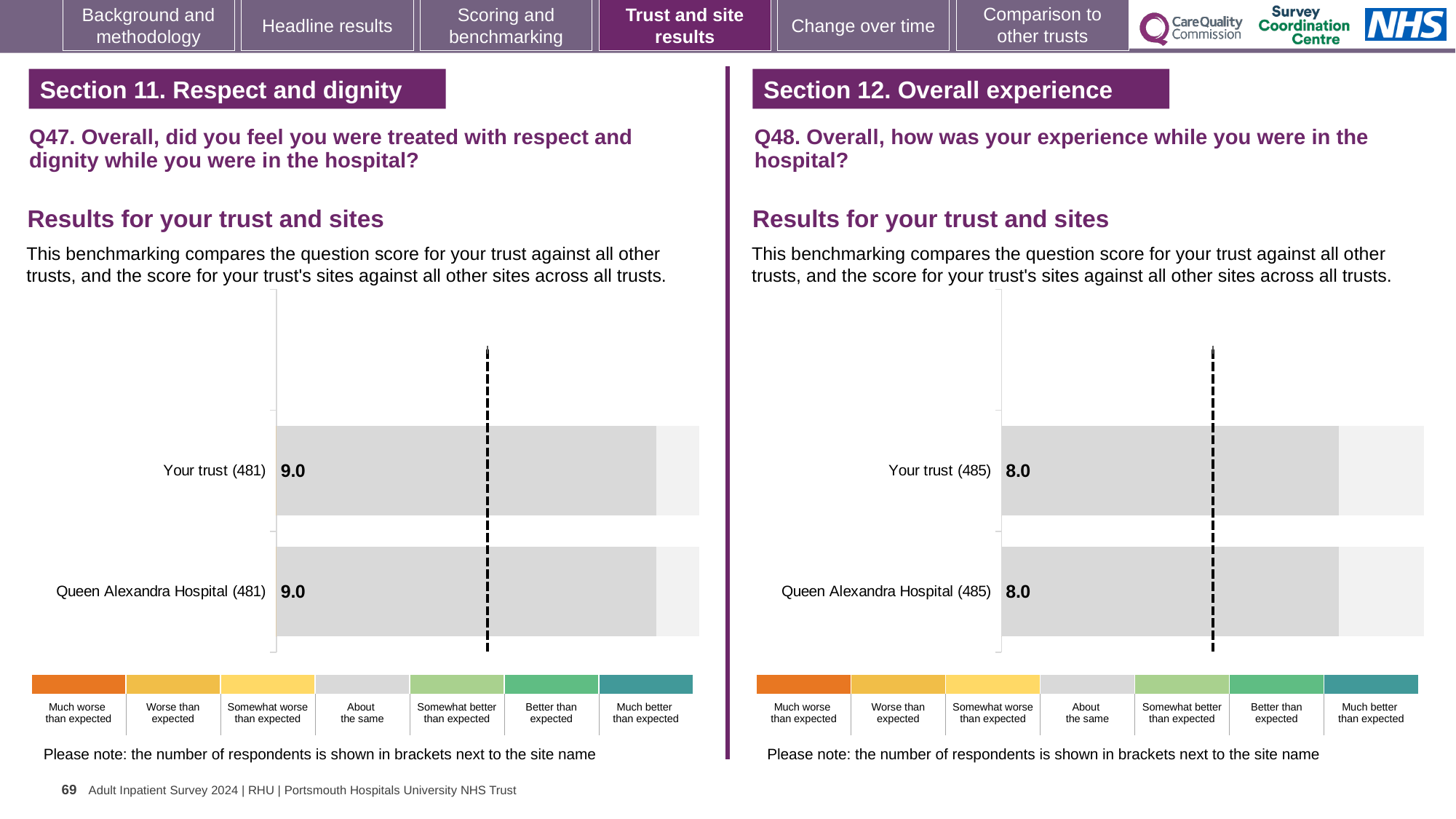
On the left chart (Q47), what is the difference between the score for Your trust and the score for Queen Alexandra Hospital? 0.0 On the right chart (Q48, overall experience), what is the score for Your trust? 8.0 On the right chart (Q48), how many respondents are shown in brackets for Queen Alexandra Hospital? 485 On the left chart (Q47, respect and dignity), what is the score for Your trust? 9.0 How many bars are plotted on the left chart (Q47)? 2 On the right chart (Q48), what is the difference between the score for Your trust and the score for Queen Alexandra Hospital? 0.0 On the left chart (Q47), which category does the colour key label with the dark orange colour at the far left? Much worse than expected On the left chart (Q47, respect and dignity), what is the score for Queen Alexandra Hospital? 9.0 On the right chart (Q48, overall experience), what is the score for Queen Alexandra Hospital? 8.0 On the left chart (Q47), how many respondents are shown in brackets for Your trust? 481 What kind of chart is used on the left (Q47) to show the results for your trust and sites? Bar chart How many bars are plotted on the right chart (Q48)? 2